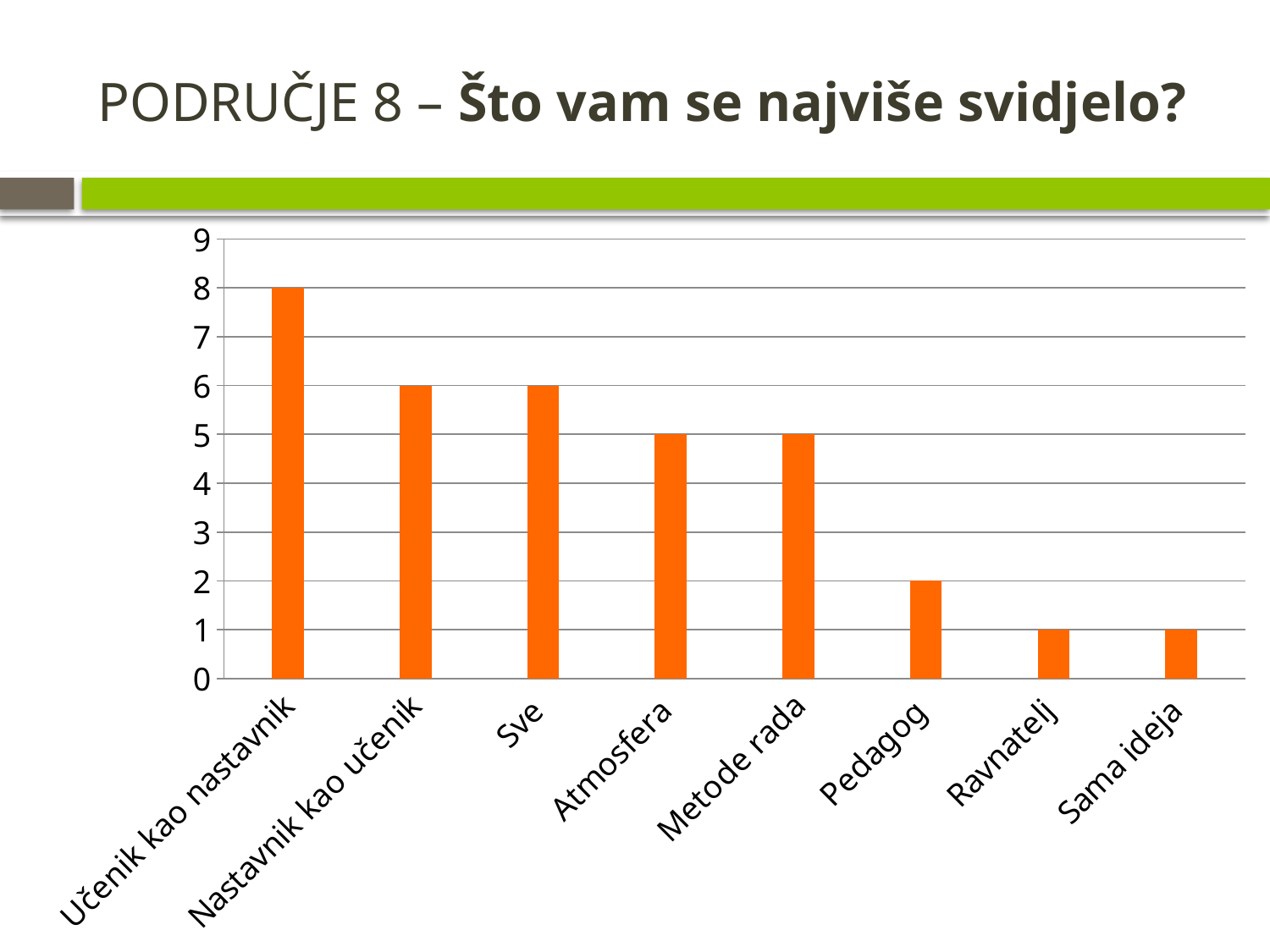
Is the value for Učenik kao nastavnik greater or less than 7? greater Which is larger, the value for Sve or the value for Sama ideja? Sve Do the values generally rise or fall from left to right along the x axis? fall What is the difference between the values for Učenik kao nastavnik and Nastavnik kao učenik? 2 What is the value for Atmosfera? 5 Which category has the highest value? Učenik kao nastavnik What is the value for Pedagog? 2 What is the value for Ravnatelj? 1 How many categories are shown on the x axis? 8 What is the difference between the values for Metode rada and Pedagog? 3 What kind of chart is shown on the slide? bar chart What is the value for Učenik kao nastavnik? 8